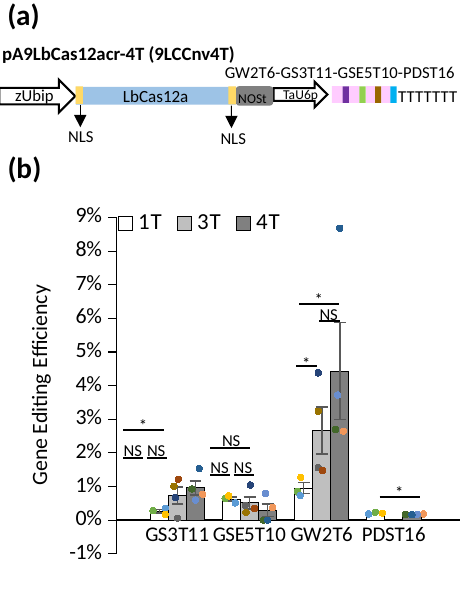
How many target categories are shown along the x axis of the chart in panel (b)? 4 What are the legend entries of the chart in panel (b)? 1T, 3T, 4T In the chart in panel (b), is the 1T value for GW2T6 greater or less than 2%? less In the chart in panel (b), which category has the highest 4T bar? GW2T6 In the chart in panel (b), which is larger: the 3T bar for GW2T6 or the 3T bar for GS3T11? GW2T6 What is the y-axis label of the chart in panel (b)? Gene Editing Efficiency In the chart in panel (b), is the 4T value for GW2T6 greater or less than 3%? greater In the chart in panel (b), is the 4T value for GS3T11 greater or less than 2%? less How many series does the legend of the chart in panel (b) list? 3 What kind of chart is shown in panel (b)? bar chart In the chart in panel (b), for GW2T6, which is larger: the 3T bar or the 4T bar? 4T